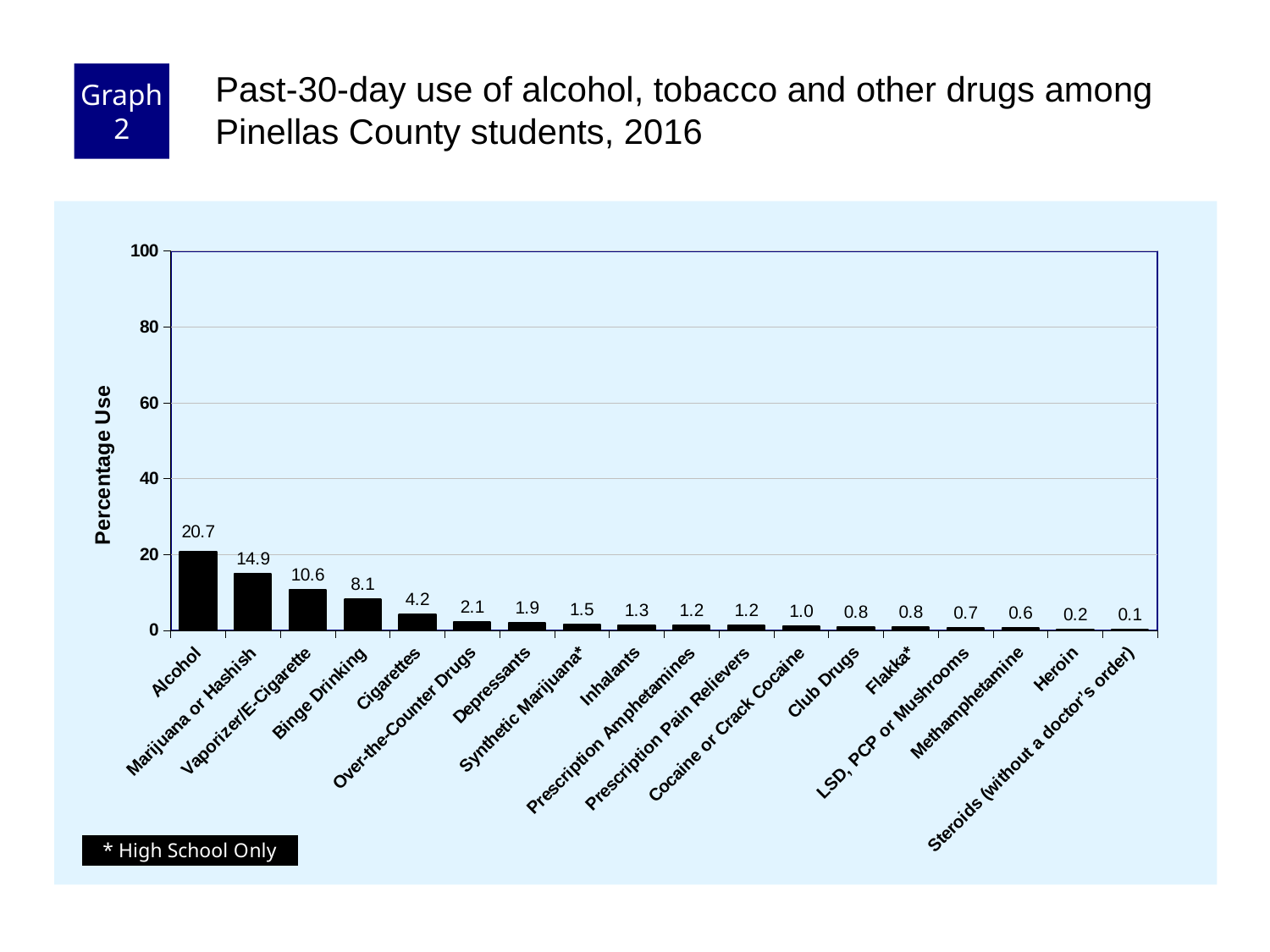
What kind of chart is shown on the slide? Bar chart Which category has the highest percentage use? Alcohol Which category has the lowest percentage use? Steroids (without a doctor's order) What is the difference in percentage use between Alcohol and Marijuana or Hashish? 5.8 How many categories are shown on the x axis? 18 What is the percentage use for Vaporizer/E-Cigarette? 10.6 Is the value for Alcohol greater or less than 20? greater What is the percentage use for Heroin? 0.2 What is the percentage use for Cigarettes? 4.2 What is the label of the y axis? Percentage Use Which has a higher percentage use, Binge Drinking or Cigarettes? Binge Drinking What is the percentage use for Alcohol? 20.7